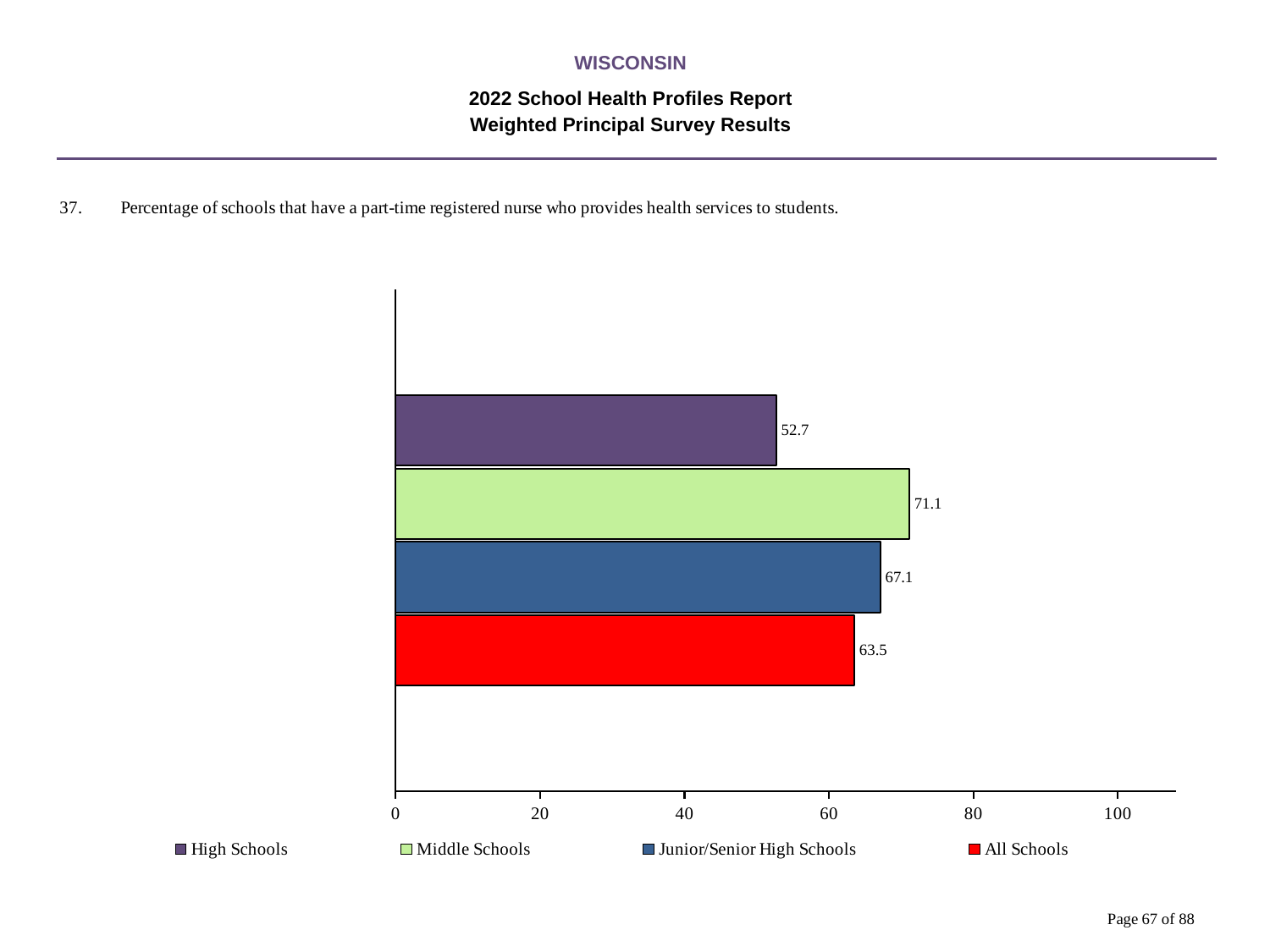
What colour is the bar for All Schools? red What kind of chart is shown on the slide? bar chart Which school type has the lowest value? High Schools What is the value for Junior/Senior High Schools? 67.1 What is the value for Middle Schools? 71.1 What is the value for All Schools? 63.5 How many series does the legend list? 4 Which is larger, the value for Junior/Senior High Schools or the value for All Schools? Junior/Senior High Schools What is the difference between the values for Middle Schools and High Schools? 18.4 Is the value for High Schools greater or less than 60? less Which school type has the highest value? Middle Schools What is the value for High Schools? 52.7